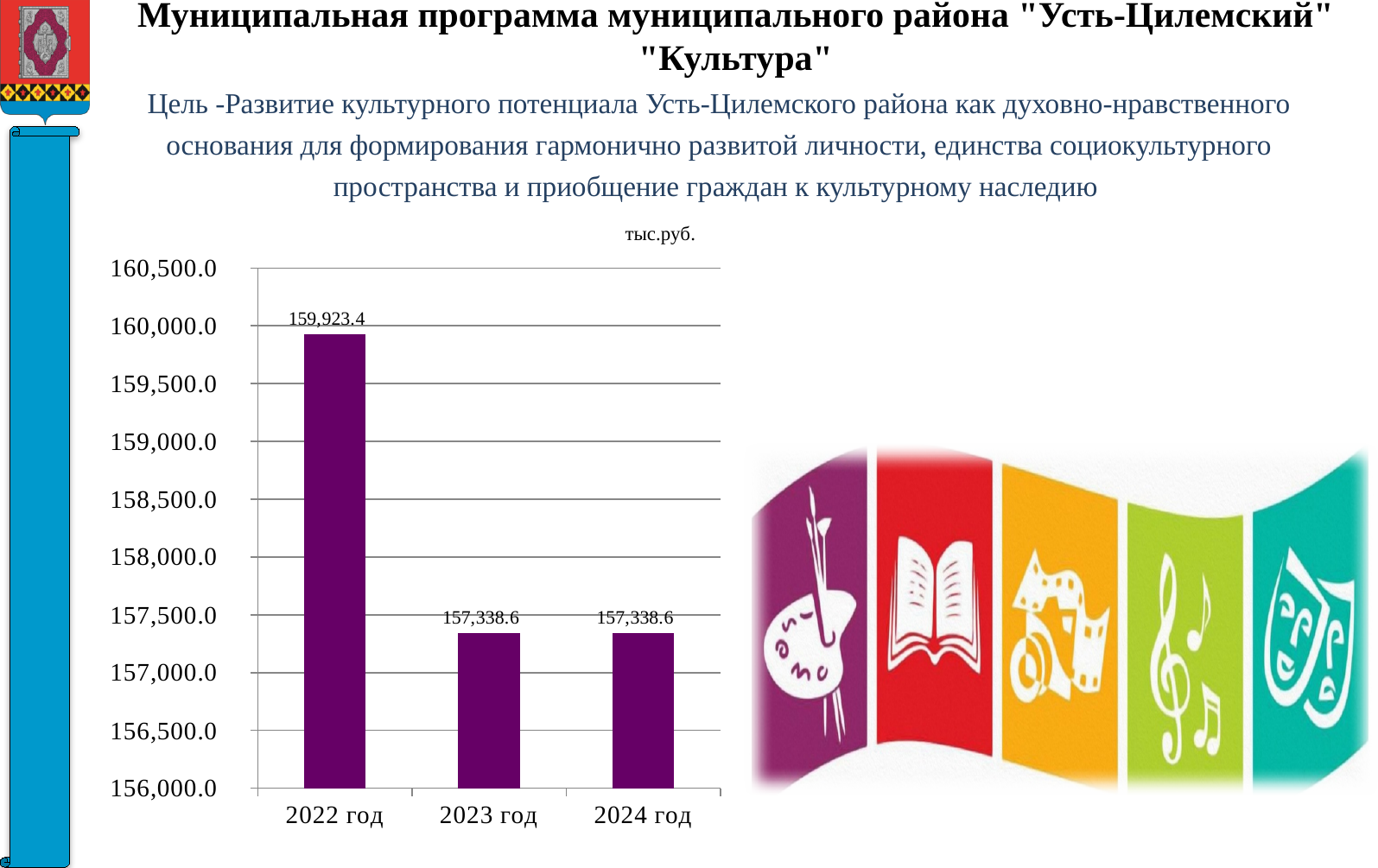
Are the values for 2023 год and 2024 год equal? Yes Which year has the highest value? 2022 год How many years are shown on the chart? 3 Which is larger, the value for 2022 год or the value for 2024 год? 2022 год What is the difference between the values for 2022 год and 2023 год? 2,584.8 Does the value rise or fall from 2022 год to 2023 год? fall Is the value for 2022 год greater or less than 159,500.0? greater What is the value for 2024 год? 157,338.6 What is the value for 2022 год? 159,923.4 Is the value for 2023 год greater or less than 157,500.0? less What kind of chart is shown on the slide? Bar chart What is the value for 2023 год? 157,338.6